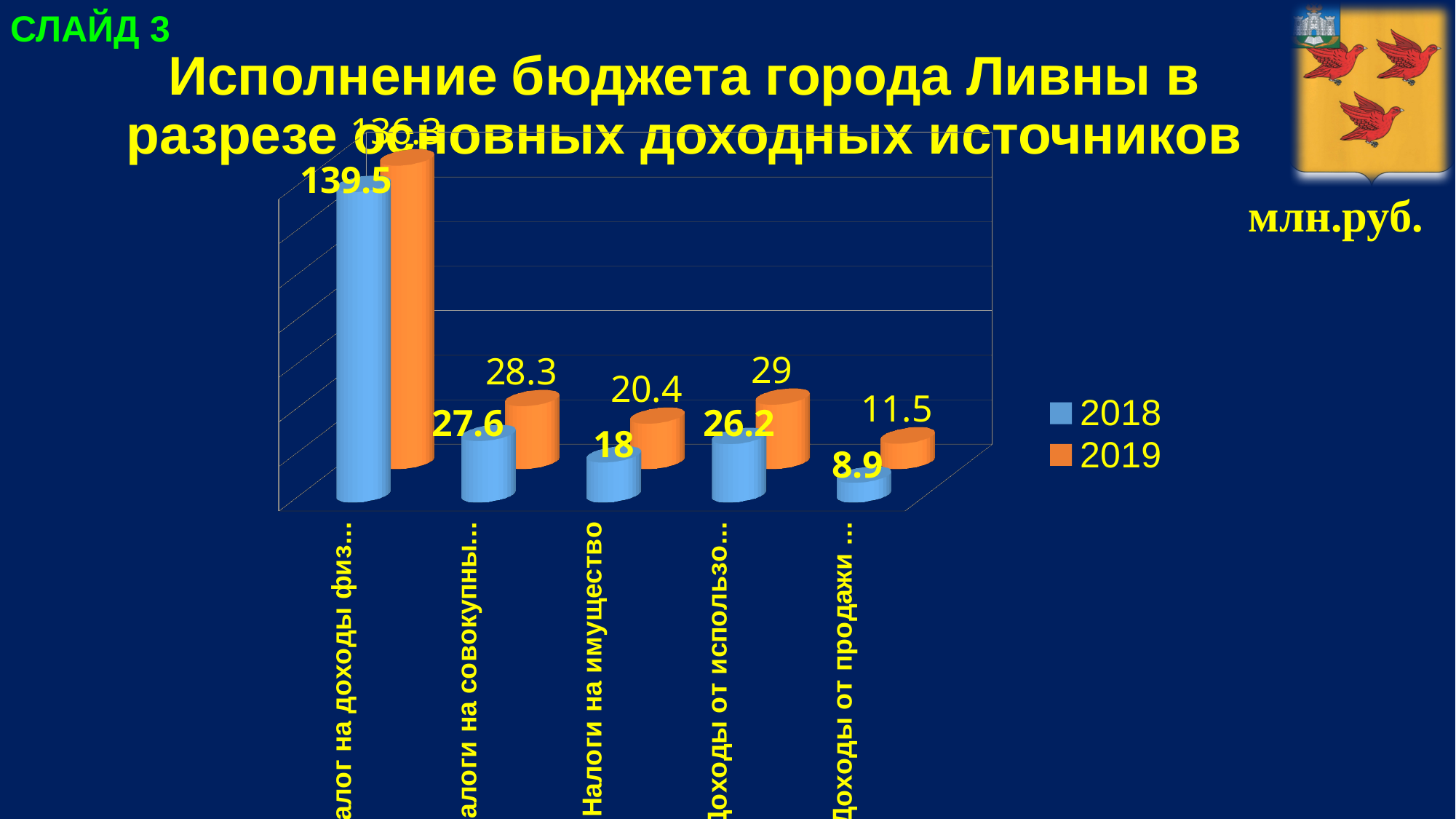
Which colour represents 2019 in the legend? orange What is the lowest 2018 value shown on the chart? 8.9 What is the 2019 value for Налоги на имущество? 20.4 Which year has the larger value for Налоги на имущество, 2018 or 2019? 2019 What kind of chart is shown on the slide? bar chart In what unit are the chart values given, according to the slide? млн.руб. What is the 2019 value for the rightmost category? 11.5 By how much did the value for Налоги на имущество increase from 2018 to 2019? 2.4 What is the 2018 value for the leftmost category? 139.5 How many series does the legend list? 2 What is the 2018 value for Налоги на имущество? 18 How many categories are shown on the x axis? 5